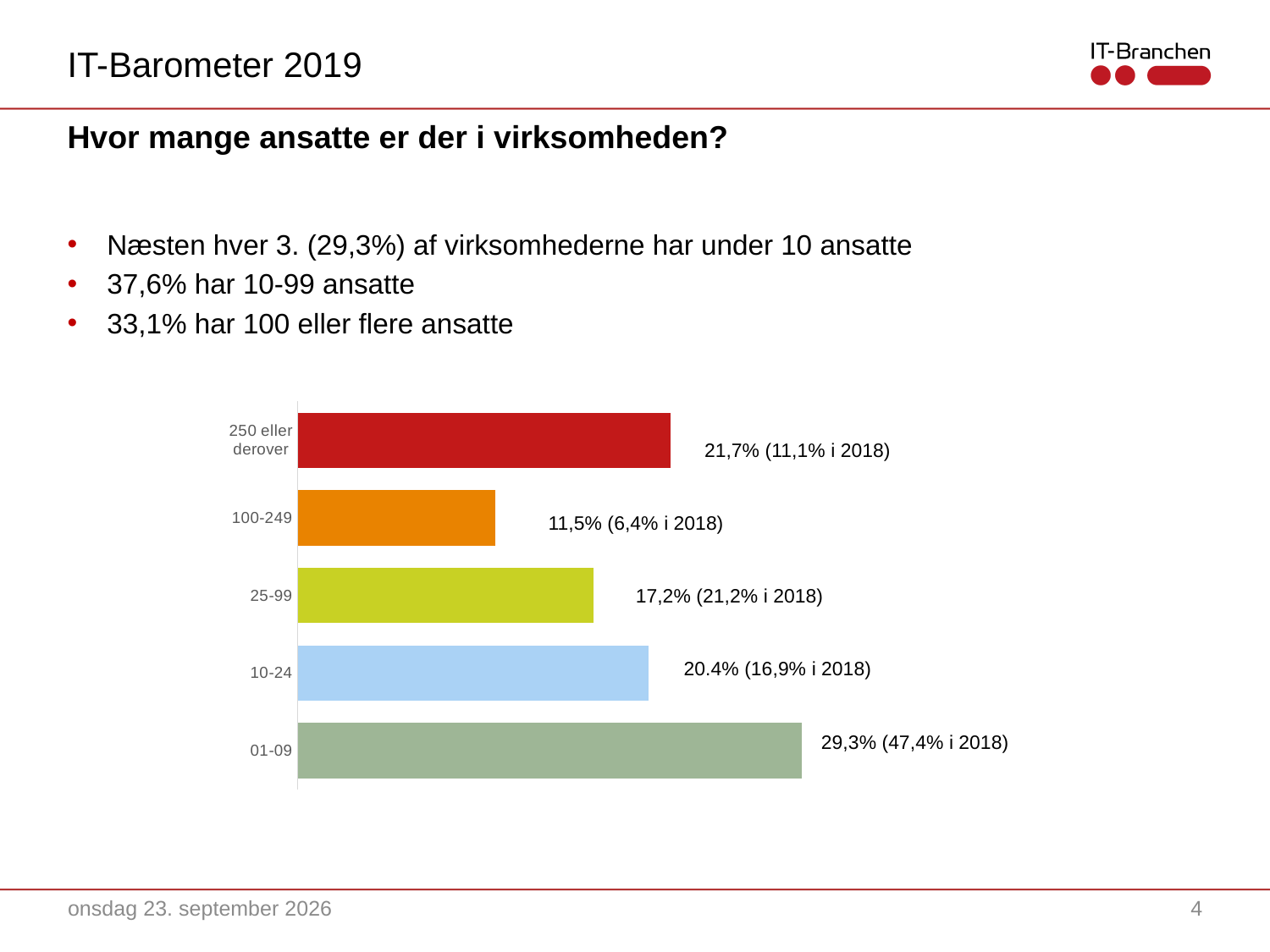
What is the value for the category 250 eller derover? 21,7% What kind of chart is shown on the slide? bar chart What is the difference between the values for 01-09 and 100-249? 17,8% According to the data label, what was the value for 01-09 in 2018? 47,4% What is the value for the category 01-09? 29,3% Which category has the highest value? 01-09 What is the value for the category 25-99? 17,2% Which category has the lowest value? 100-249 What is the value for the category 100-249? 11,5% Which is larger, the value for 25-99 or the value for 100-249? 25-99 Which category is shown with a red bar? 250 eller derover How many categories does the chart show? 5